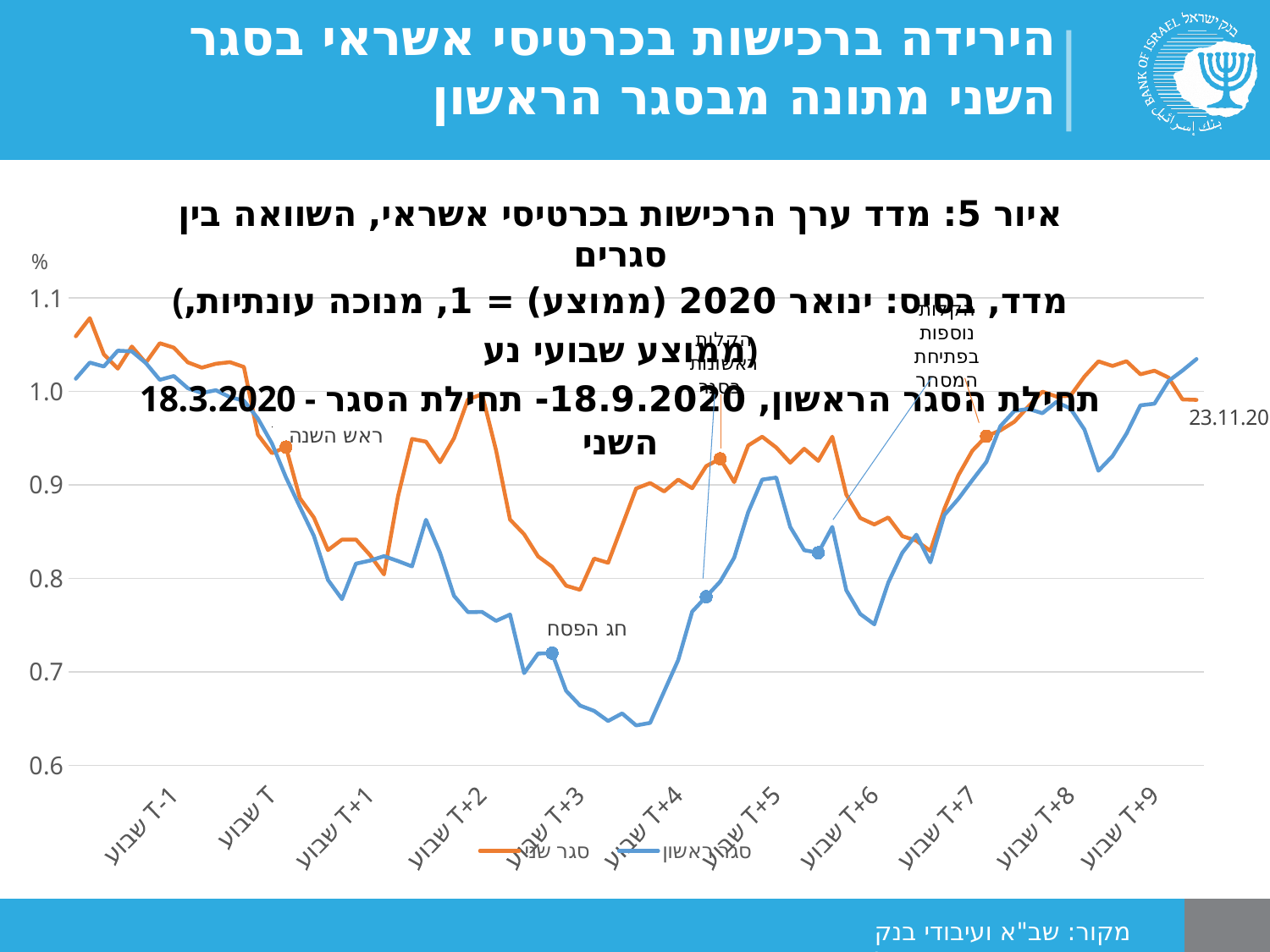
At שבוע T+4, which series has the lower value, סגר שני or סגר ראשון? סגר ראשון Is the value of the סגר ראשון (blue) series at שבוע T+3 greater or less than 0.7? less Is the value of the סגר ראשון (blue) series at שבוע T+6 greater or less than 0.8? less Does the סגר ראשון (blue) series generally rise or fall from שבוע T+3 to שבוע T+9? rise At שבוע T+3, which series has the higher value, סגר שני or סגר ראשון? סגר שני What kind of chart is shown on the slide? line chart What are the two series named in the legend? סגר שני and סגר ראשון What is the highest value shown on the y axis? 1.1 Is the value of the סגר שני (orange) series at שבוע T+2 greater or less than 0.9? greater How many series does the legend list? 2 Around which week does the סגר ראשון (blue) series reach its lowest point? שבוע T+4 How many week categories are shown on the x axis? 11